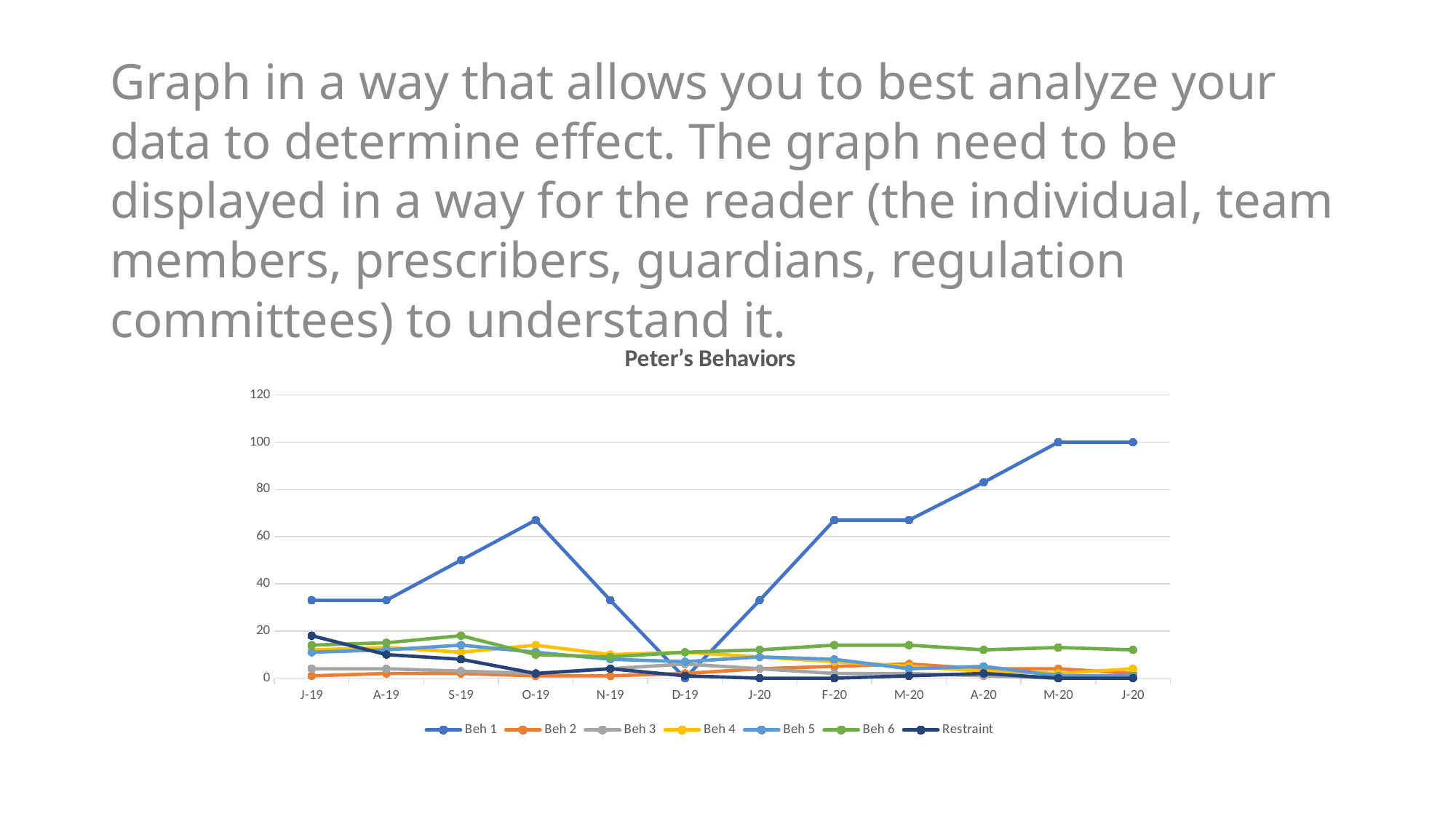
Is the value for Beh 1 at A-20 greater or less than 80? greater How many series does the legend list? 7 What is the value for Beh 1 at J-20 (the last point)? 100 What kind of chart is shown on the slide? line chart At which x-axis point is Beh 1 lowest? D-19 Does Beh 1 rise or fall from J-20 (January) to J-20 (June) at the end of the x axis? rise Is the value for Beh 1 at O-19 greater or less than 60? greater Which is larger at F-20, Beh 1 or Beh 6? Beh 1 How many points are on the x axis of the chart? 12 What is the title of the chart? Peter's Behaviors